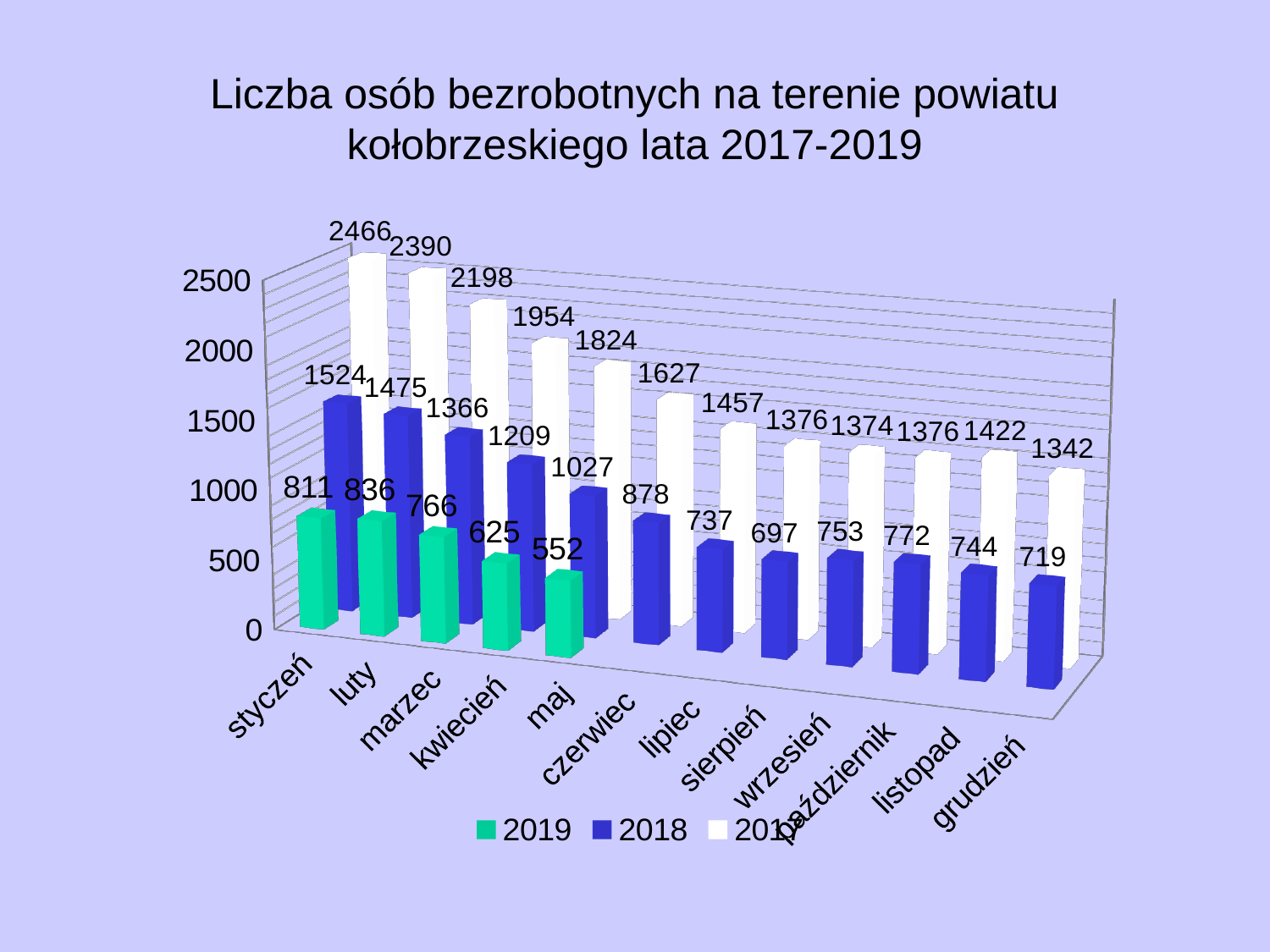
What is the value for 2019 in maj? 552 What is the value for 2017 in grudzień? 1342 How many months are shown on the x axis? 12 How many series does the legend list? 3 What is the value for 2018 in styczeń? 1524 What kind of chart is shown on the slide? bar chart Which month has the highest value for the 2017 series? styczeń Which month has the lowest value for the 2018 series? sierpień Which is larger: the 2018 value in luty or the 2018 value in marzec? luty What is the difference between the 2017 and 2018 values in styczeń? 942 What is the value for 2018 in sierpień? 697